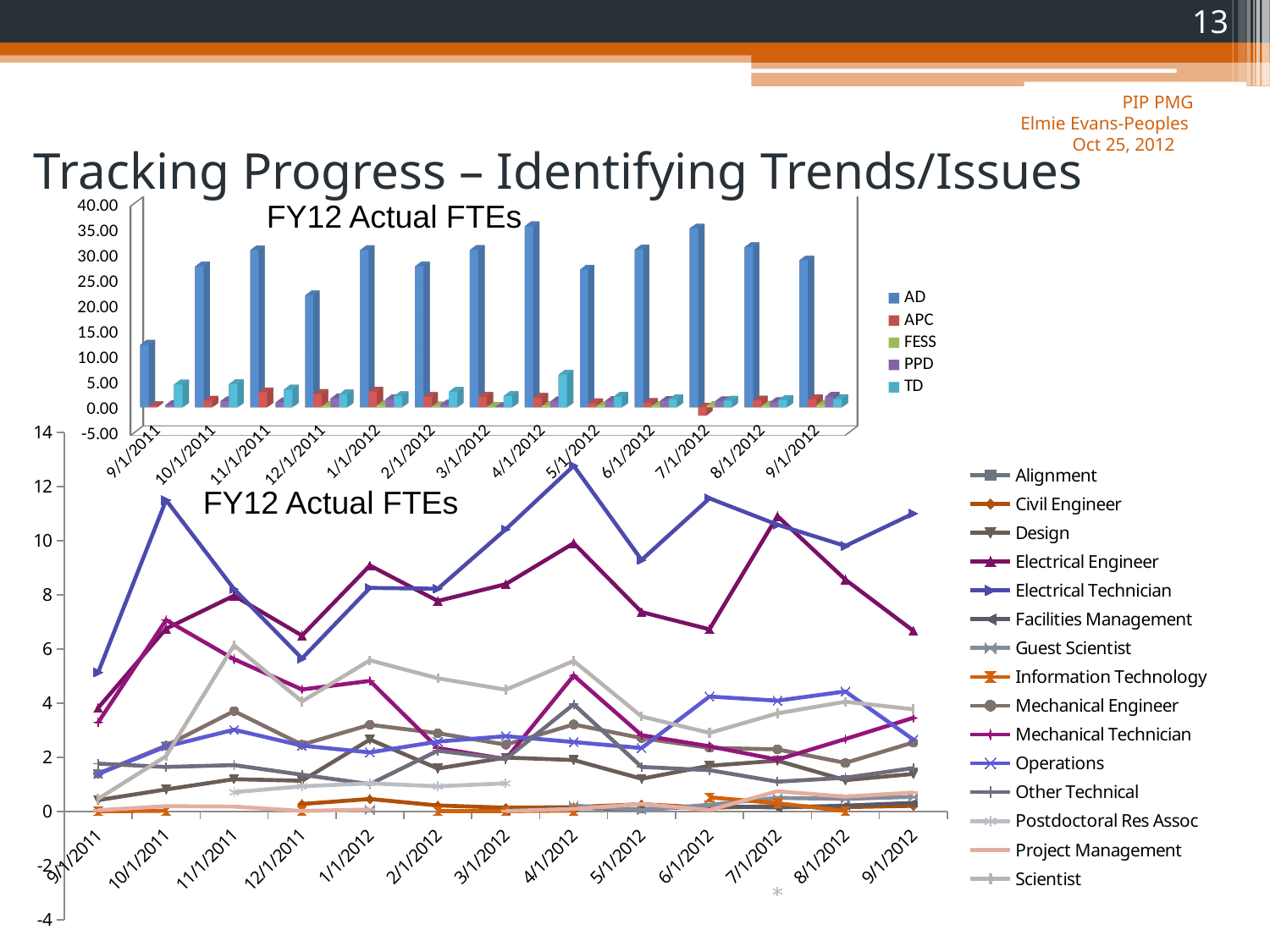
How many dates are shown along the x axis of the top bar chart? 13 In the bottom line chart, on which date does the Electrical Technician series reach its highest value? 4/1/2012 In the top bar chart, is the AD value for 4/1/2012 greater or less than 30.00? greater How many series does the legend of the top bar chart list? 5 What is the title of the top bar chart? FY12 Actual FTEs How many series does the legend of the bottom line chart list? 15 What kind of chart is the top chart on the slide? bar chart What kind of chart is the bottom chart on the slide? line chart In the top bar chart, is the AD value for 9/1/2011 greater or less than 15.00? less In the bottom line chart, which is larger at 9/1/2012: Electrical Technician or Electrical Engineer? Electrical Technician In the bottom line chart, is the Electrical Technician value for 5/1/2012 greater or less than 12? less In the top bar chart, on which date is the AD value lowest? 9/1/2011